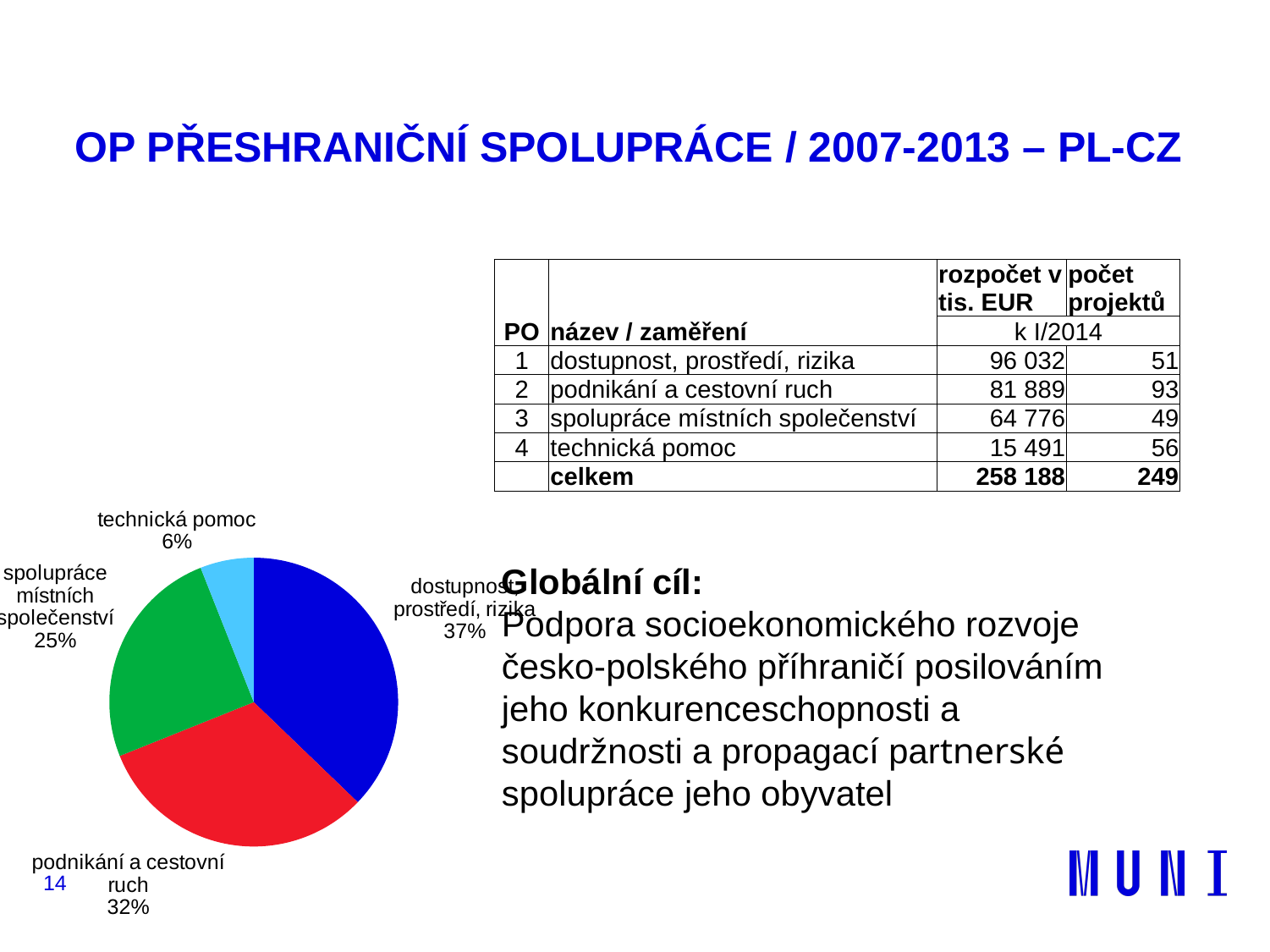
What colour is the "podnikání a cestovní ruch" slice in the pie chart? red What share of the pie does "technická pomoc" represent? 6% What is the difference in percentage points between the "podnikání a cestovní ruch" slice and the "spolupráce místních společenství" slice? 7 Which slice of the pie chart is the smallest? technická pomoc What share of the pie does "spolupráce místních společenství" represent? 25% Which slice is larger: "spolupráce místních společenství" or "technická pomoc"? spolupráce místních společenství What share of the pie does "podnikání a cestovní ruch" represent? 32% What colour is the "technická pomoc" slice in the pie chart? light blue What kind of chart is shown on the slide? pie chart How many slices does the pie chart have? 4 Which slice of the pie chart is the largest? dostupnost, prostředí, rizika